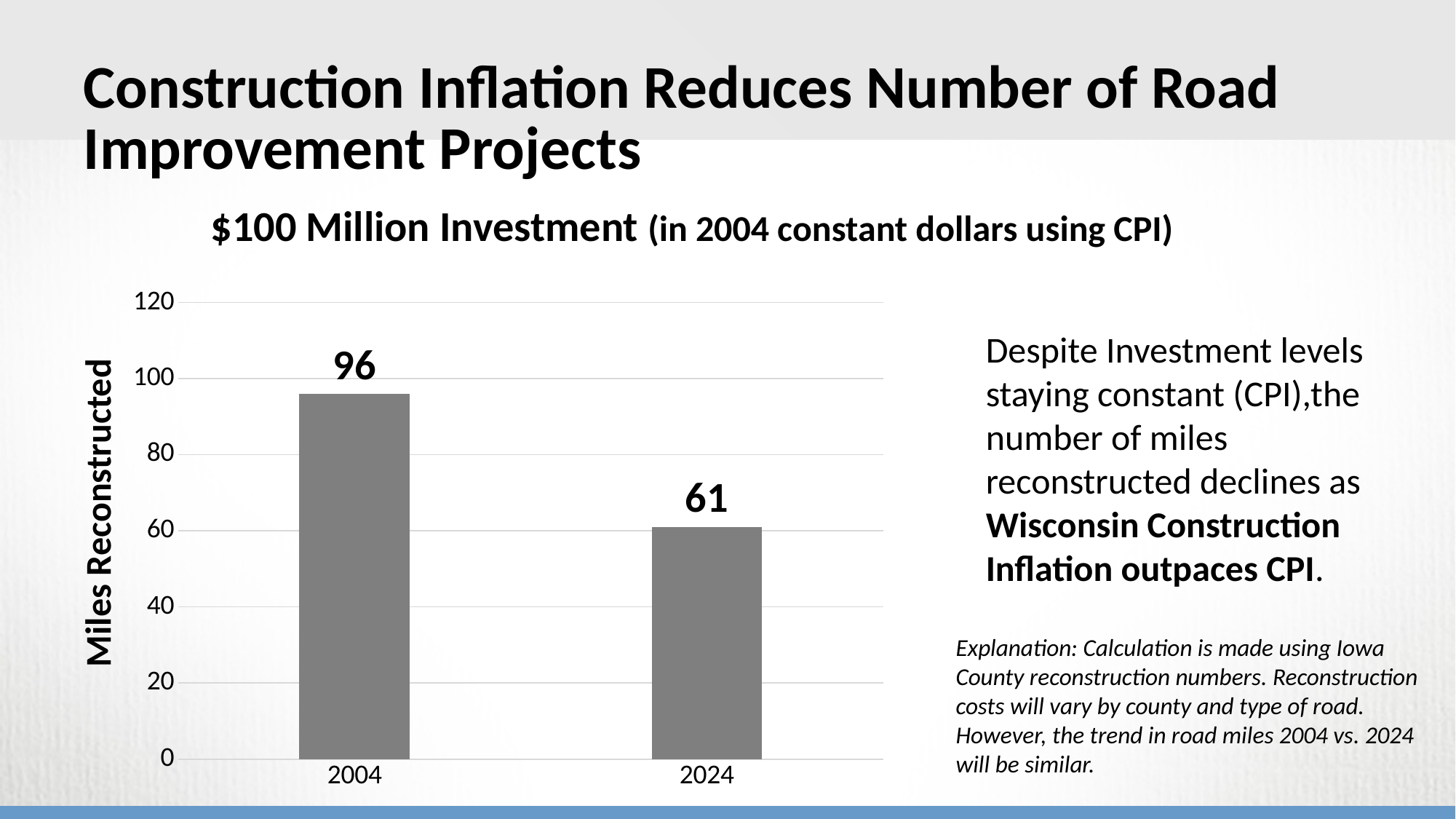
Which year has the lower number of miles reconstructed? 2024 What is the difference in miles reconstructed between 2004 and 2024? 35 Do the values rise or fall from 2004 to 2024? fall What kind of chart is shown on the slide? bar chart How many miles were reconstructed in 2024? 61 Is the value for 2004 greater or less than 80? greater Is the value for 2024 greater or less than 80? less Which year has the higher number of miles reconstructed? 2004 What is the label on the vertical axis of the chart? Miles Reconstructed How many years are shown on the x axis of the chart? 2 What is the title of the chart? $100 Million Investment (in 2004 constant dollars using CPI) How many miles were reconstructed in 2004? 96